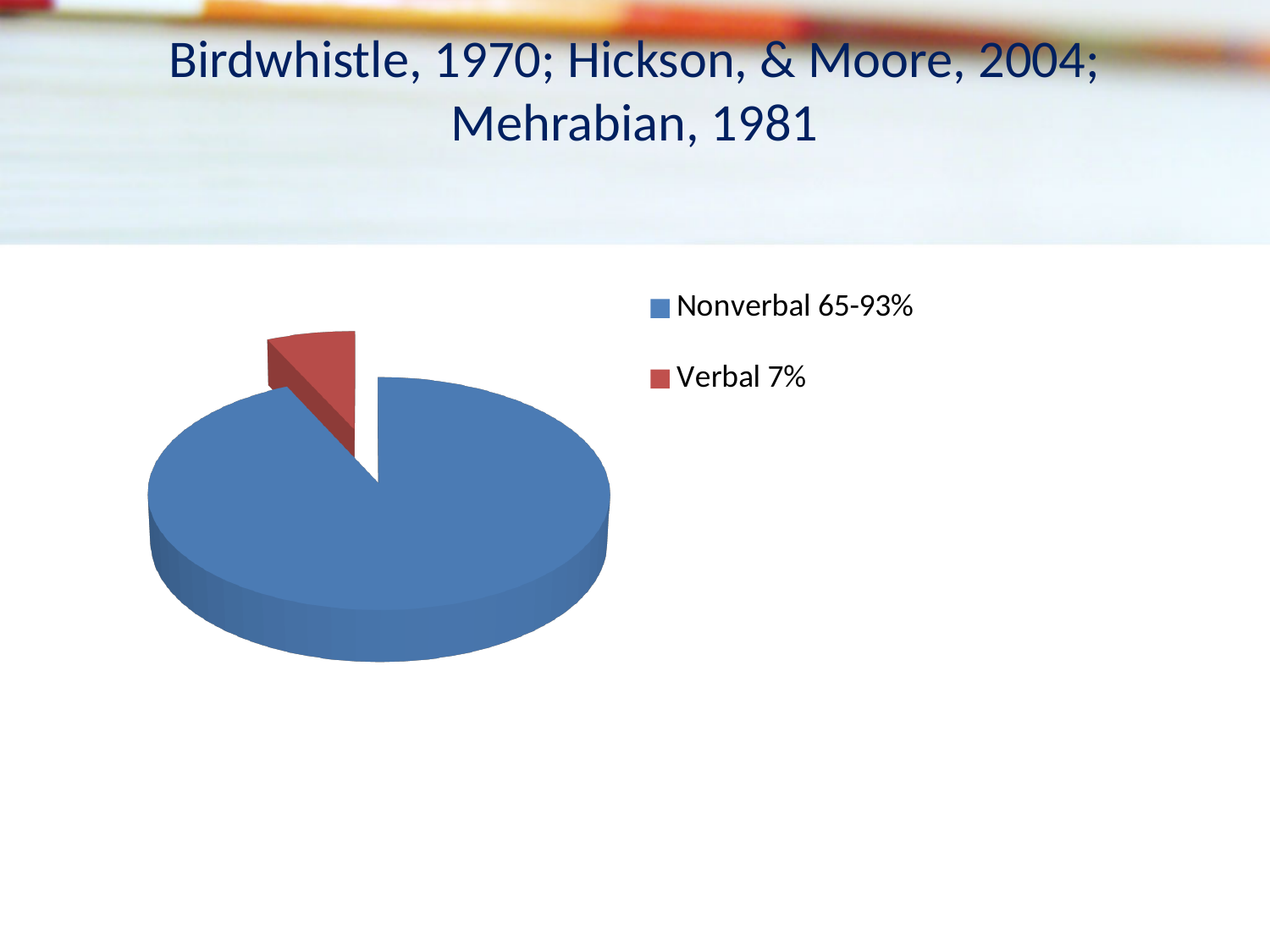
Which slice of the pie chart is the smallest? Verbal 7% What percentage is given for Verbal in the legend? 7% Which is larger in the pie chart, the Nonverbal slice or the Verbal slice? Nonverbal What range is given for Nonverbal in the legend? 65-93% Which slice of the pie chart is the largest? Nonverbal 65-93% How many slices does the pie chart have? 2 What colour is the Verbal slice of the pie chart? red What kind of chart is shown on the slide? pie chart How many entries does the legend list? 2 What colour is the Nonverbal slice of the pie chart? blue